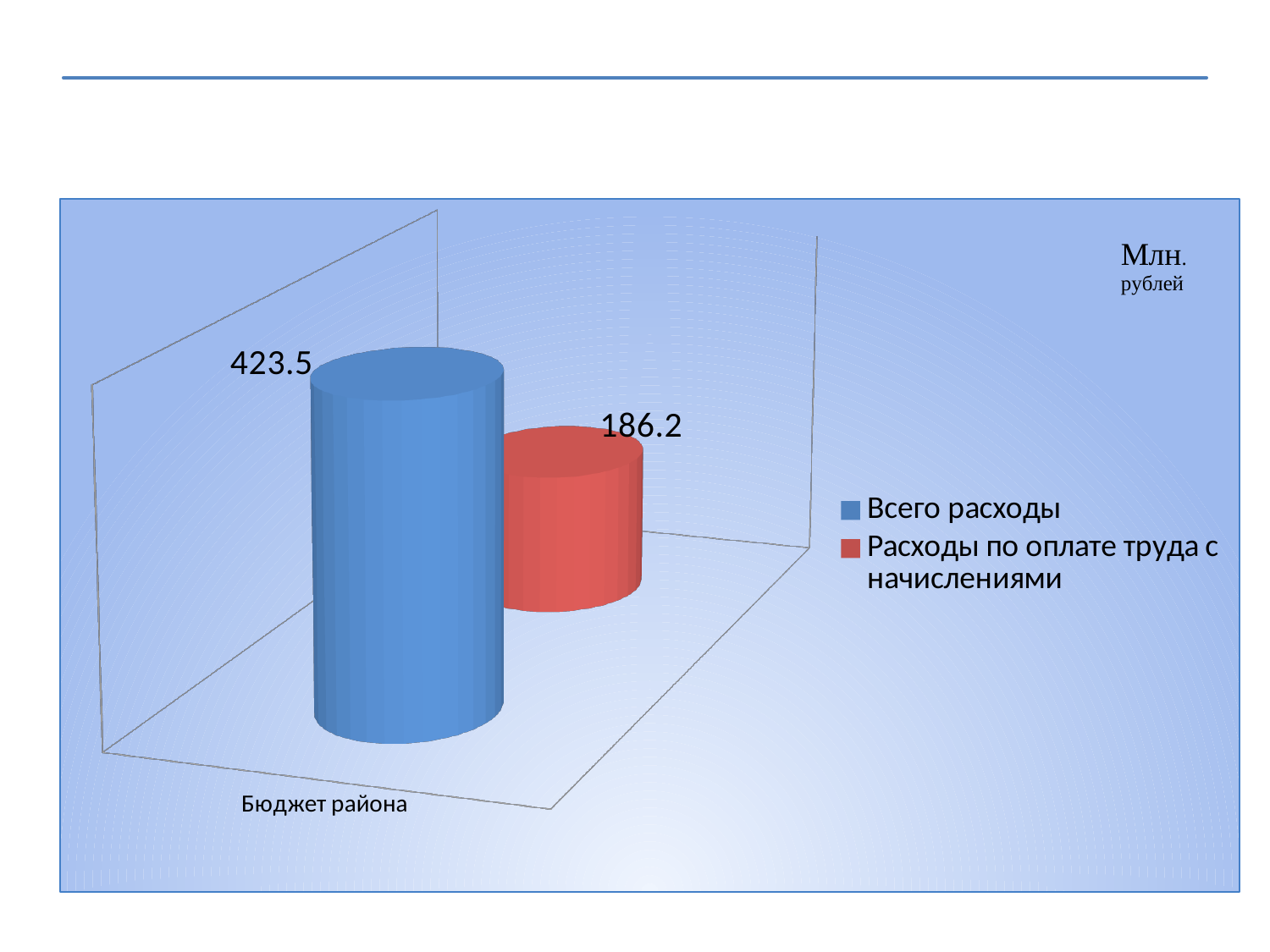
How many series does the legend list? 2 What kind of chart is shown on the slide? Bar chart What is the category label shown on the x axis? Бюджет района Which series has the lowest value in the chart? Расходы по оплате труда с начислениями What is the value for "Всего расходы" in the chart? 423.5 What unit is indicated in the top right corner of the chart? Млн. рублей How many categories are shown on the x axis of the chart? 1 Which series has the higher value, "Всего расходы" or "Расходы по оплате труда с начислениями"? Всего расходы What is the value for "Расходы по оплате труда с начислениями" in the chart? 186.2 What is the difference between "Всего расходы" and "Расходы по оплате труда с начислениями"? 237.3